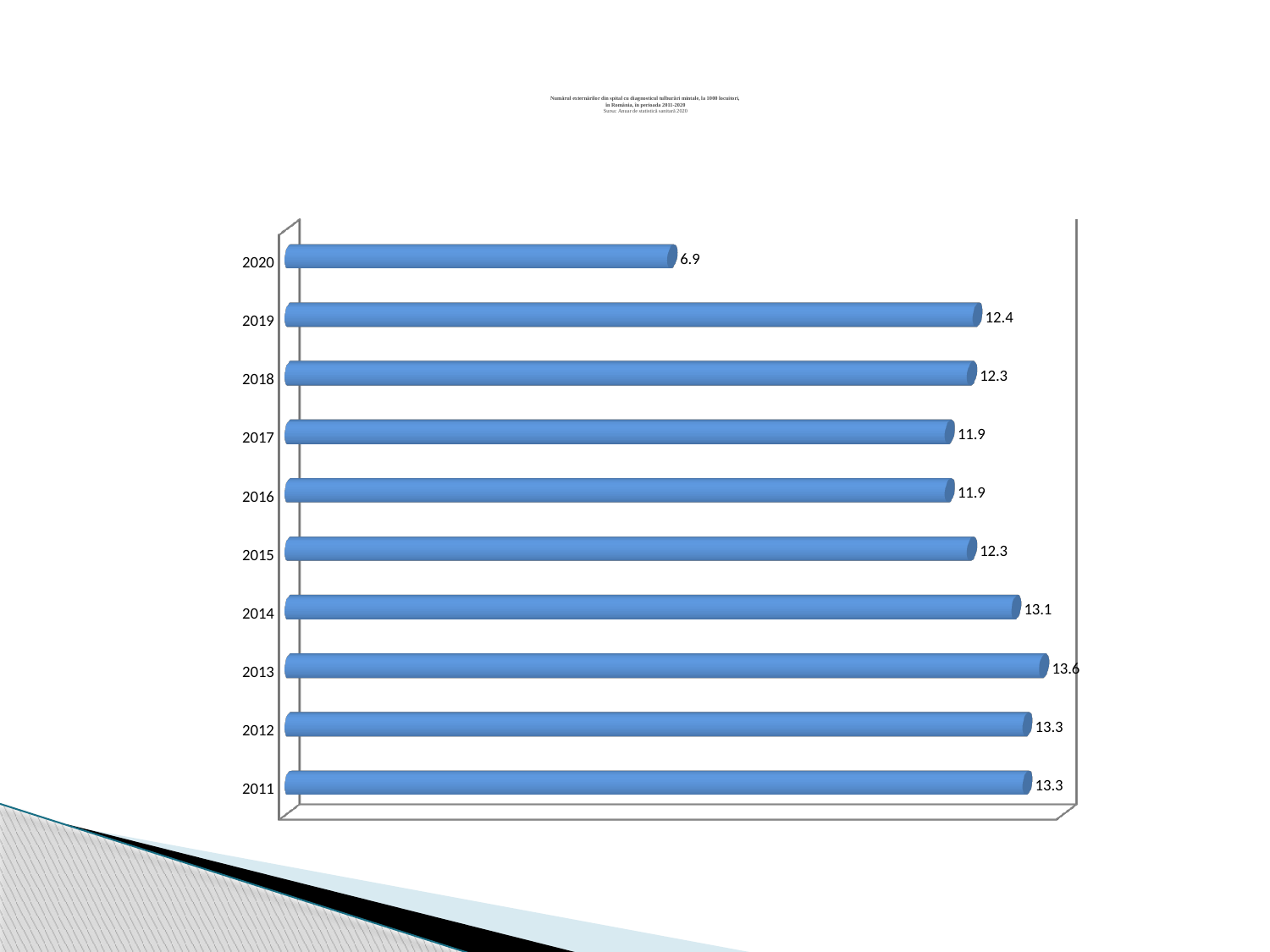
What is the value for 2019? 12.4 What kind of chart is shown on the slide? Bar chart What is the value for 2020? 6.9 What is the value for 2013? 13.6 Which is larger, the value for 2014 or the value for 2015? 2014 Which year has the highest value? 2013 Which year has the lowest value? 2020 What is the difference between the values for 2013 and 2014? 0.5 What is the difference between the values for 2019 and 2020? 5.5 What colour are the bars in the chart? Blue What is the value for 2016? 11.9 How many years are shown in the chart? 10